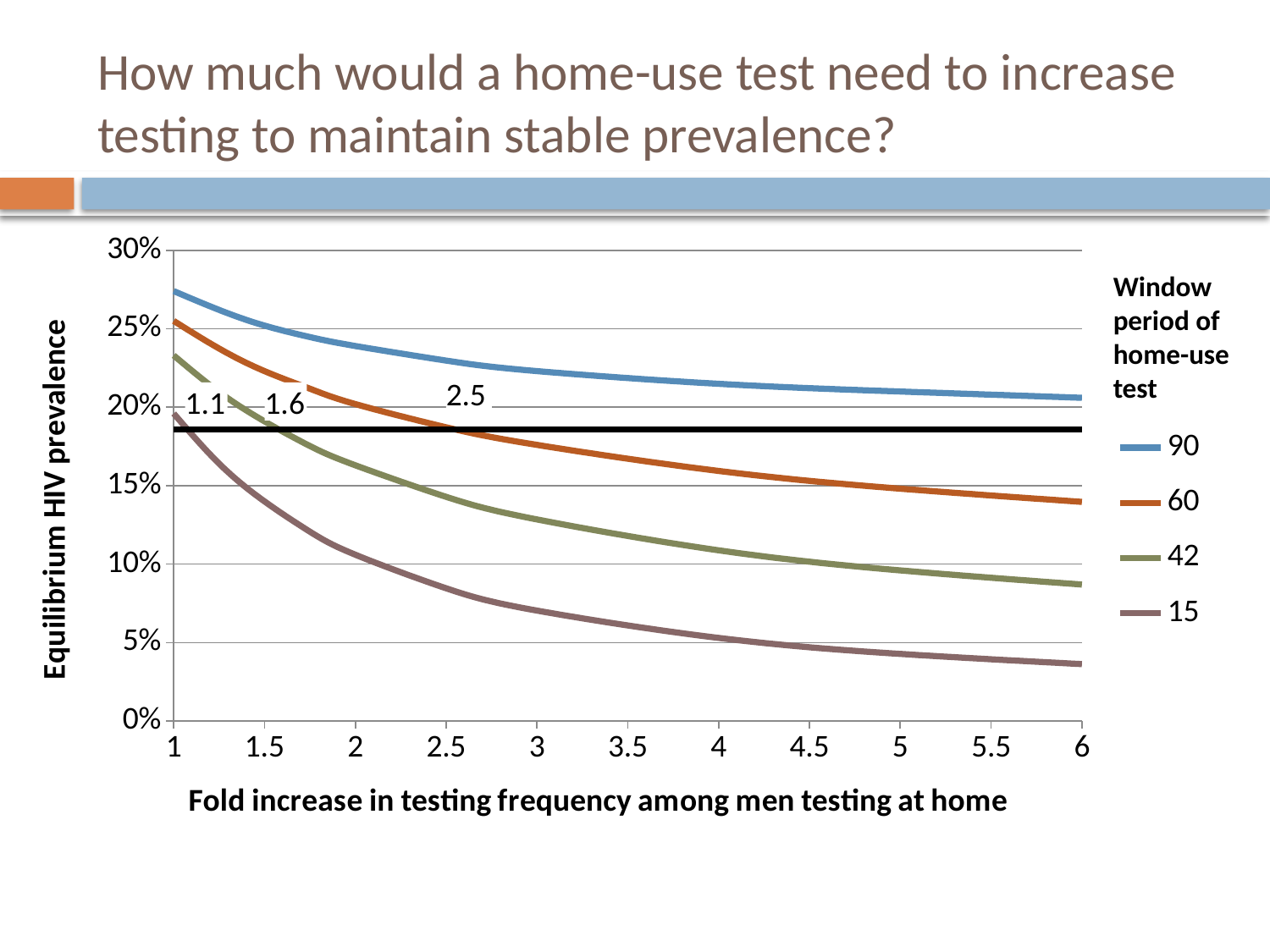
Which series has the highest equilibrium HIV prevalence at a fold increase of 6? 90 Is the value for the 90 series at a fold increase of 1 greater or less than 25%? greater Which series has the lowest equilibrium HIV prevalence at a fold increase of 6? 15 How many series does the legend list? 4 What is the title of the legend? Window period of home-use test Is the value for the 42 series at a fold increase of 3 greater or less than 15%? less Do the values for the 15 series rise or fall as the fold increase in testing frequency goes from 1 to 6? fall What fold increase is labeled where the 60 series crosses the black horizontal line? 2.5 What is the label of the y axis? Equilibrium HIV prevalence At a fold increase of 4, which series has the larger equilibrium HIV prevalence, 60 or 42? 60 Is the value for the 15 series at a fold increase of 6 greater or less than 5%? less What kind of chart is shown on the slide? line chart